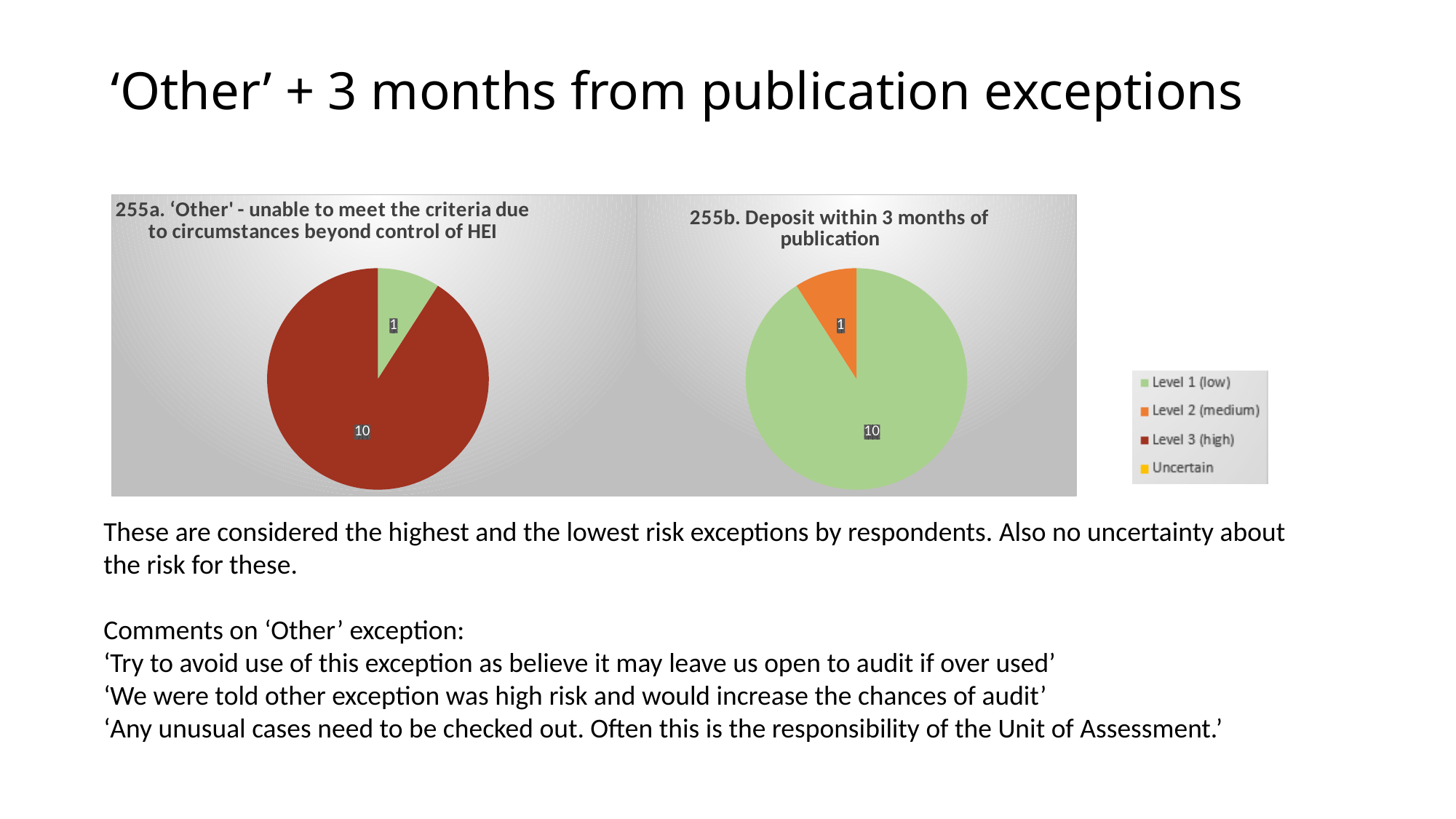
What kind of chart is used for '255b. Deposit within 3 months of publication'? Pie chart In the right chart (255b), which is larger: Level 1 (low) or Level 2 (medium)? Level 1 (low) In the chart titled '255a. ‘Other' - unable to meet the criteria due to circumstances beyond control of HEI', what is the value for Level 1 (low)? 1 In the left chart (255a), what is the difference between the Level 3 (high) value and the Level 1 (low) value? 9 How many entries does the legend on the slide list? 4 In the right chart (255b), which risk level has the smallest slice? Level 2 (medium) In the chart titled '255b. Deposit within 3 months of publication', what is the value for Level 2 (medium)? 1 In the left chart (255a), which risk level has the largest slice? Level 3 (high) What colour represents Level 3 (high) in the legend? Dark red In the chart titled '255a. ‘Other' - unable to meet the criteria due to circumstances beyond control of HEI', what is the value for Level 3 (high)? 10 How many slices does the left chart (255a) have? 2 In the chart titled '255b. Deposit within 3 months of publication', what is the value for Level 1 (low)? 10